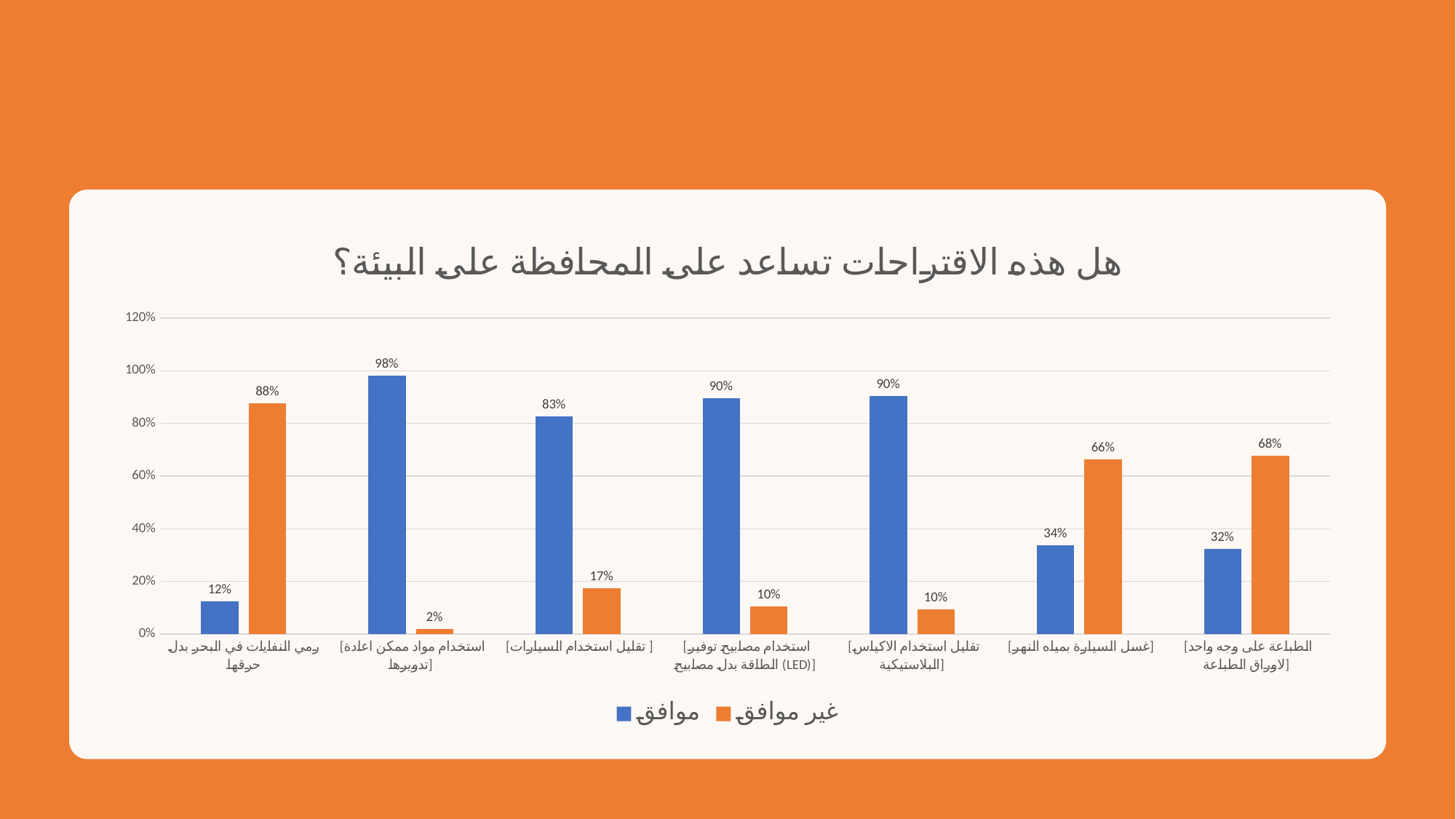
What is the موافق value for غسل السيارة بمياه النهر? 34% Which colour represents the غير موافق series? Orange What is the difference between the غير موافق values for الطباعة على وجه واحد لاوراق الطباعة and غسل السيارة بمياه النهر? 2% What is the title of the chart? هل هذه الاقتراحات تساعد على المحافظة على البيئة؟ Which is larger for تقليل استخدام السيارات: the موافق value or the غير موافق value? موافق What type of chart is shown on the slide? Bar chart What is the موافق value for استخدام مواد ممكن اعادة تدويرها? 98% Which category has the lowest غير موافق value? استخدام مواد ممكن اعادة تدويرها How many series does the legend list? 2 How many categories are shown on the x axis? 7 Which category has the highest موافق value? استخدام مواد ممكن اعادة تدويرها What is the غير موافق value for رمي النفايات في البحر بدل حرقها? 88%